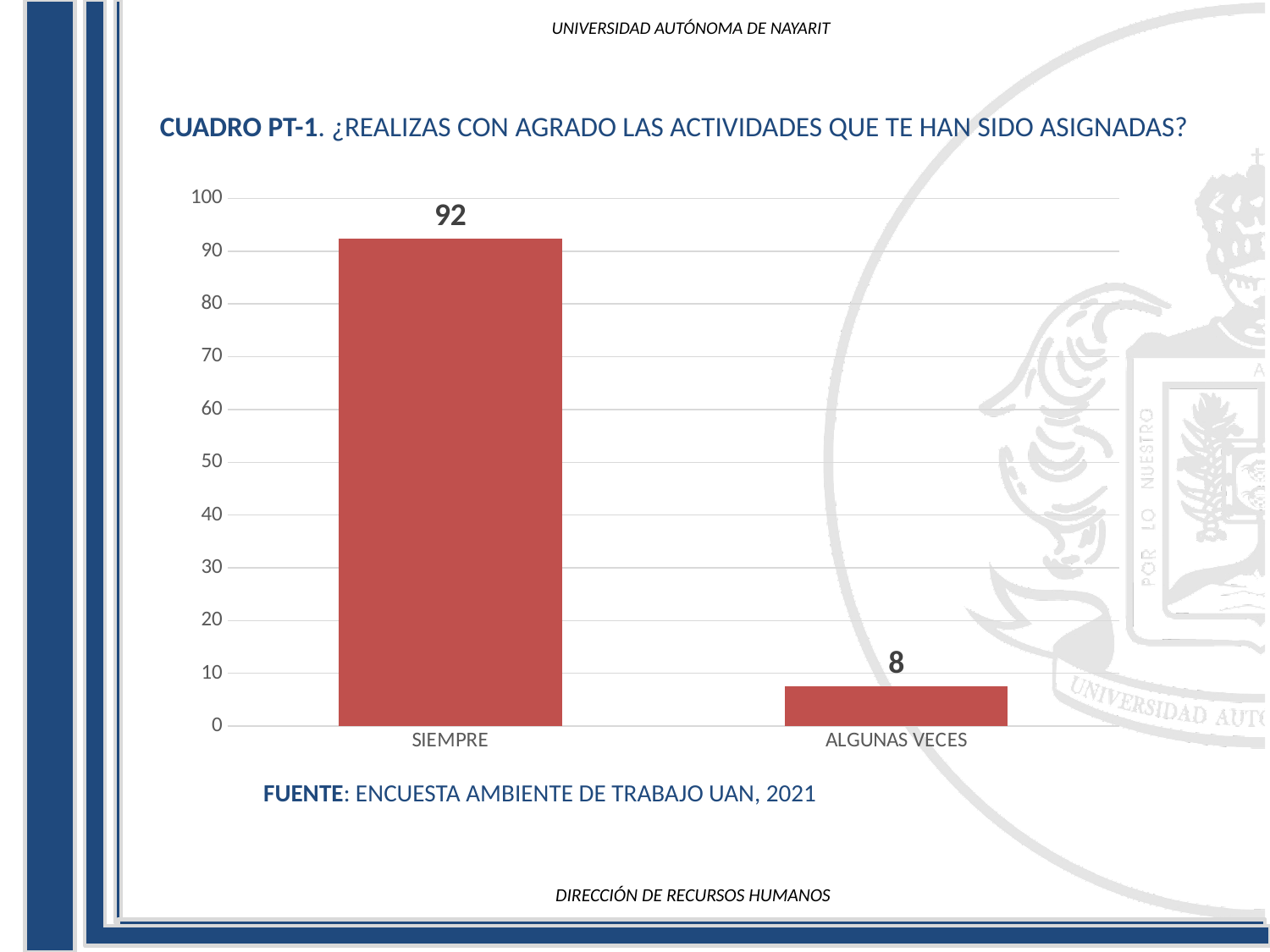
What is the value for SIEMPRE? 92 Which category has the lowest value? ALGUNAS VECES What is the difference between the values for SIEMPRE and ALGUNAS VECES? 84 What is the value for ALGUNAS VECES? 8 What is the total of the two values shown in the chart? 100 What kind of chart is shown on the slide? bar chart Is the value for SIEMPRE greater or less than 50? greater How many categories are shown on the x axis? 2 Which is larger, the value for SIEMPRE or the value for ALGUNAS VECES? SIEMPRE What source is cited below the chart? ENCUESTA AMBIENTE DE TRABAJO UAN, 2021 Which category has the highest value? SIEMPRE Is the value for ALGUNAS VECES greater or less than 10? less